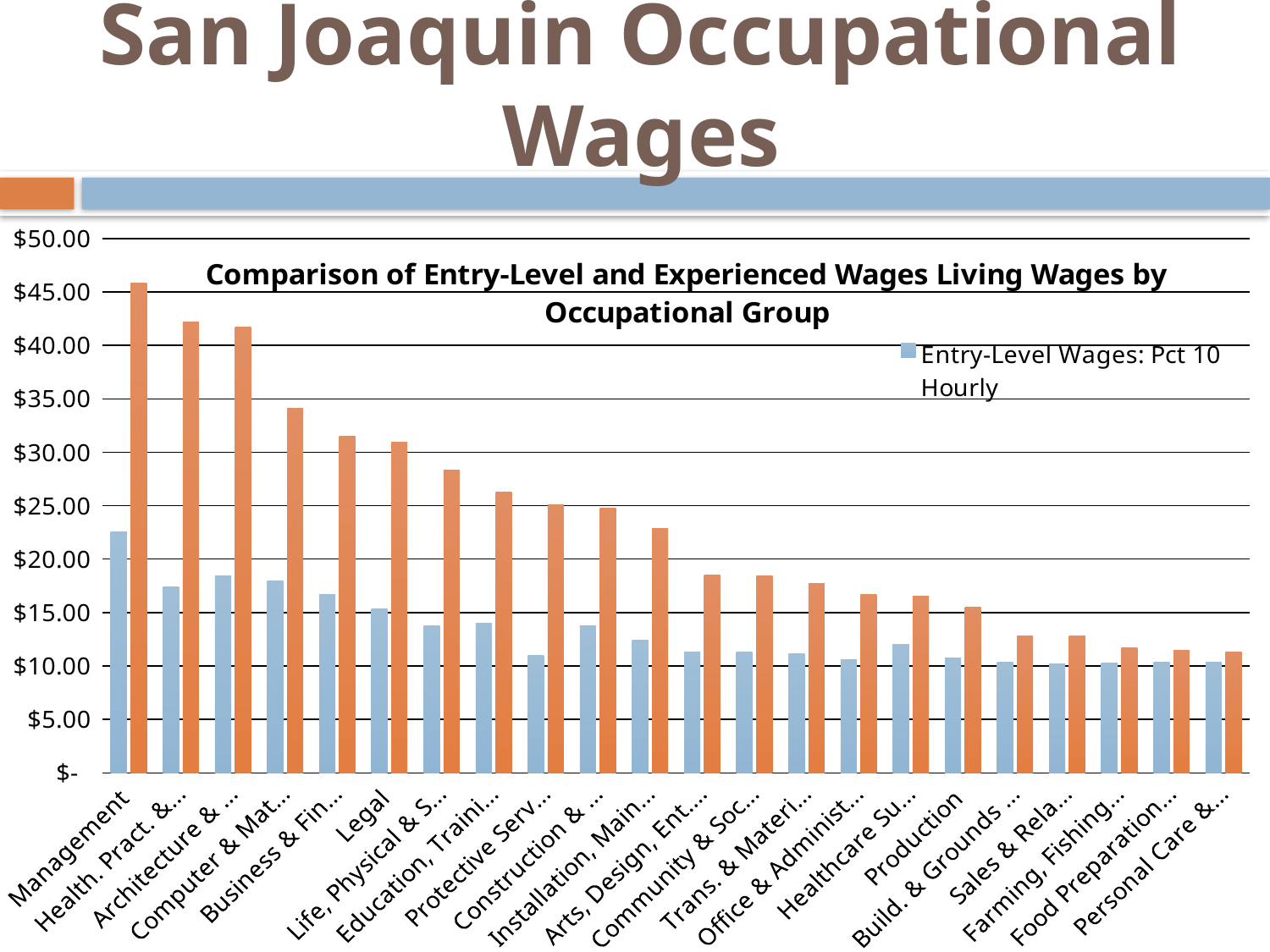
Which occupational group has the highest orange bar in the chart? Management Which has the taller Entry-Level Wages: Pct 10 Hourly bar, Management or Production? Management What is the title of the chart? Comparison of Entry-Level and Experienced Wages Living Wages by Occupational Group What kind of chart is shown on the slide? bar chart Is the orange bar for Management greater or less than $40.00? greater Is the orange bar for Legal greater or less than $25.00? greater How many occupational groups are shown on the x axis of the chart? 22 Is the orange bar for Computer & Mat... greater or less than $30.00? greater Do the orange bars generally rise or fall moving from left to right along the x axis? fall Which occupational group has the highest Entry-Level Wages: Pct 10 Hourly (blue) bar? Management Which has the taller orange bar, Management or Legal? Management